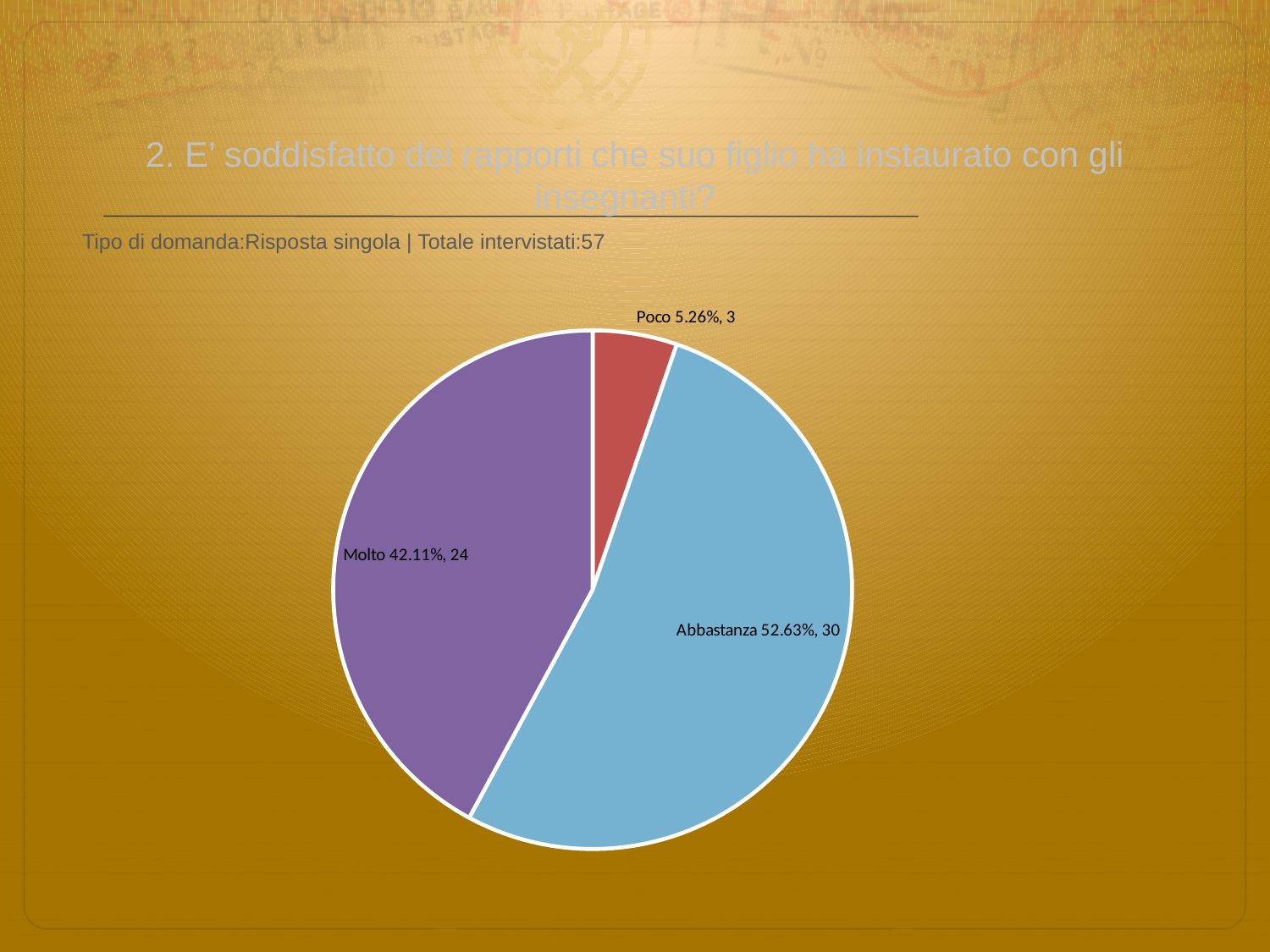
How many respondents answered Abbastanza? 30 Which category has the largest slice of the pie? Abbastanza What kind of chart is shown on the slide? pie chart What is the difference in respondent count between Abbastanza and Molto? 6 How many respondents answered Poco? 3 Which has more respondents, Molto or Poco? Molto How many slices does the pie chart have? 3 Which category has the smallest slice of the pie? Poco How many respondents answered Molto? 24 What percentage share does the Molto slice have? 42.11% What percentage share does the Poco slice have? 5.26% What percentage share does the Abbastanza slice have? 52.63%